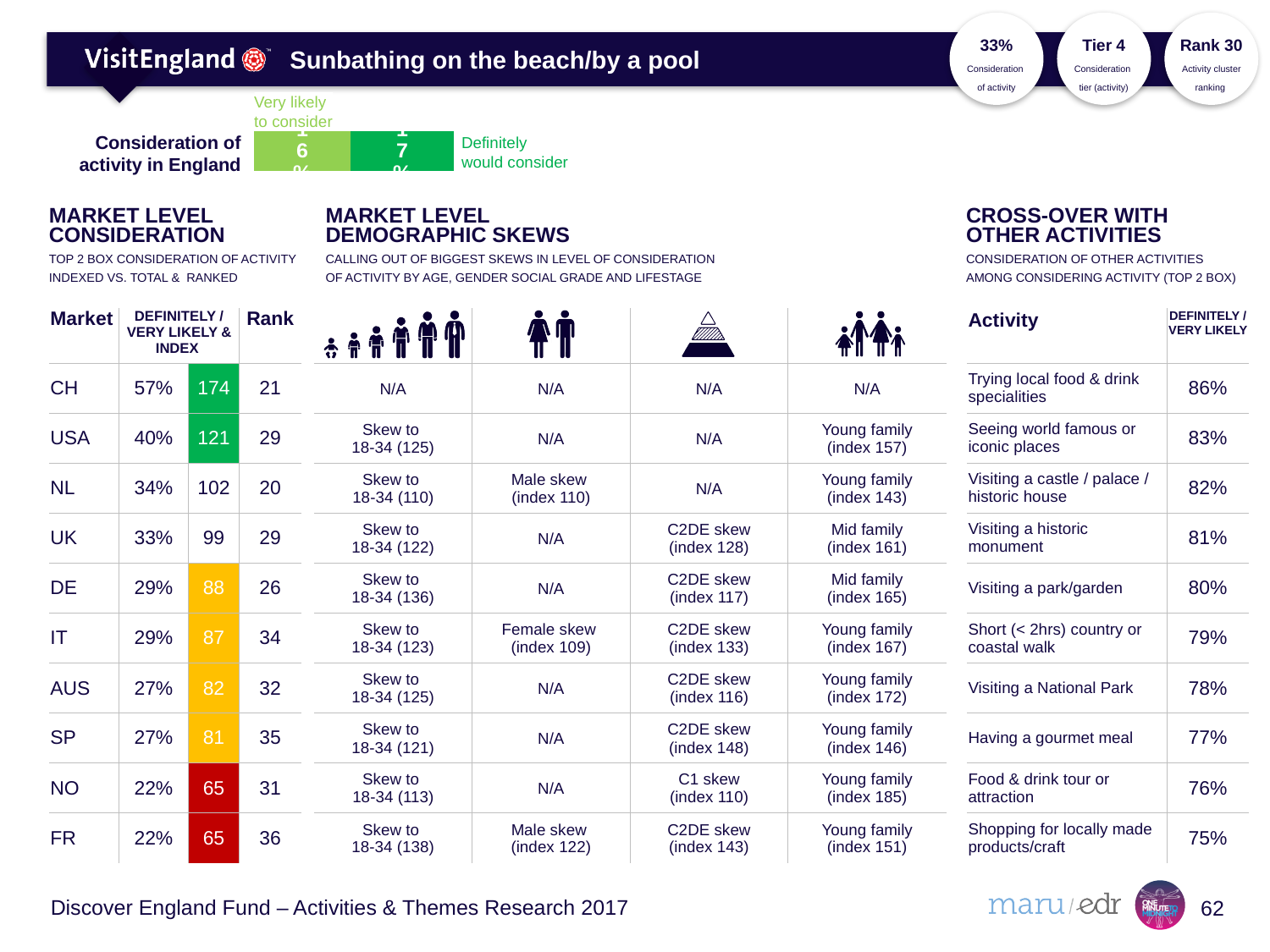
In the 'Consideration of activity in England' chart, what does the darker green segment represent? Definitely would consider What kind of chart is the 'Consideration of activity in England' chart? bar chart How many segments (series) does the 'Consideration of activity in England' bar have? 2 In the 'Consideration of activity in England' chart, what does the lighter green segment represent? Very likely to consider In the 'Consideration of activity in England' chart, what is the total of the two segments? 33% In the 'Consideration of activity in England' chart, which segment is larger, 'Very likely to consider' or 'Definitely would consider'? Definitely would consider In the 'Consideration of activity in England' chart, what is the value for 'Definitely would consider'? 17% In the 'Consideration of activity in England' chart, what is the value for 'Very likely to consider'? 16%